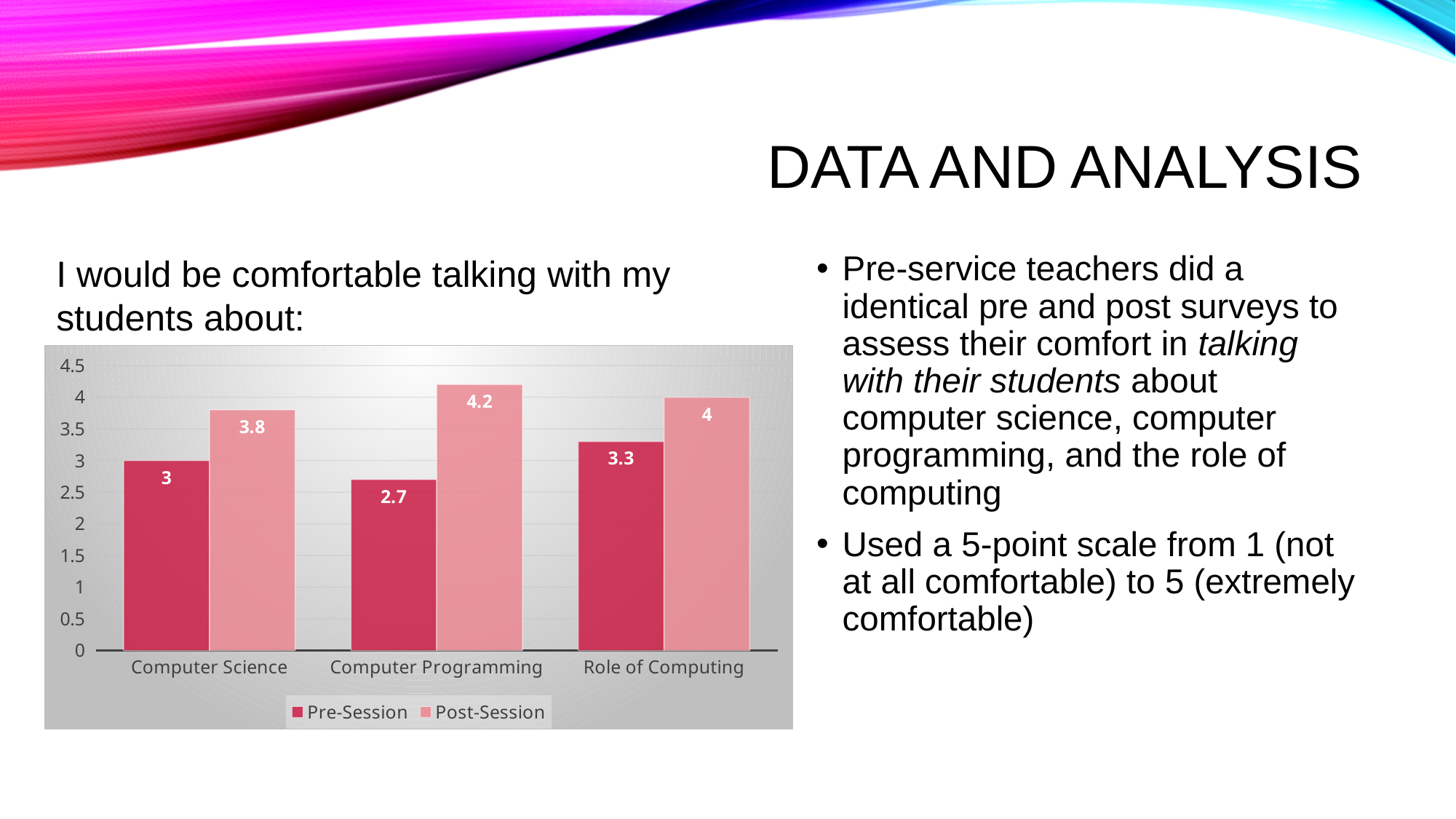
Is the Post-Session value for Computer Programming greater or less than 4? greater How many categories are shown on the x axis? 3 What is the Post-Session value for Computer Programming? 4.2 Which is larger, the Post-Session value for Computer Science or the Post-Session value for Role of Computing? Role of Computing What kind of chart is shown on the slide? bar chart Which category has the lowest Pre-Session value? Computer Programming What is the Pre-Session value for Role of Computing? 3.3 What is the difference between the Post-Session and Pre-Session values for Computer Programming? 1.5 What is the Post-Session value for Role of Computing? 4 What is the Pre-Session value for Computer Science? 3 Which category has the highest Post-Session value? Computer Programming How many series does the legend list? 2